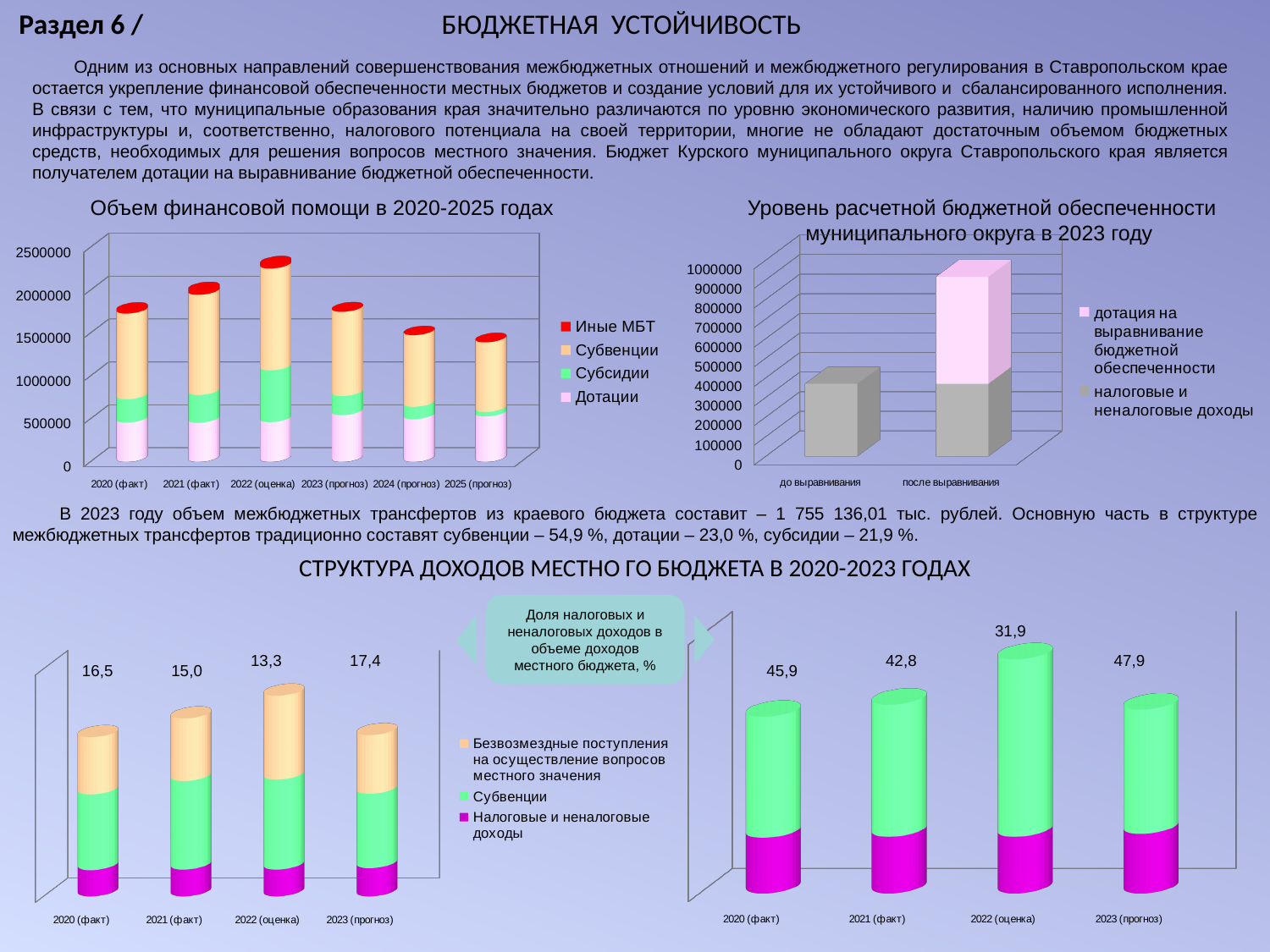
In the bottom-right chart, which year has the highest labelled value? 2023 (прогноз) In the bottom-left chart (share of tax and non-tax revenues), what is the value labelled for 2023 (прогноз)? 17,4 In the chart 'Уровень расчетной бюджетной обеспеченности муниципального округа в 2023 году', which category has the taller bar? после выравнивания In the chart 'Объем финансовой помощи в 2020-2025 годах', how many series does the legend list? 4 In the chart 'Объем финансовой помощи в 2020-2025 годах', is the total for 2020 (факт) greater or less than 2000000? less In the chart 'Уровень расчетной бюджетной обеспеченности муниципального округа в 2023 году', is the value for 'до выравнивания' greater or less than 500000? less In the chart 'Объем финансовой помощи в 2020-2025 годах', how many categories are shown on the x axis? 6 What kind of chart is the bottom-right chart? bar chart In the bottom-left chart (share of tax and non-tax revenues), what is the difference between the labelled values for 2023 (прогноз) and 2022 (оценка)? 4,1 In the bottom-left chart (share of tax and non-tax revenues), which year has the lowest labelled value? 2022 (оценка) In the chart 'Объем финансовой помощи в 2020-2025 годах', which category has the highest total bar? 2022 (оценка) In the bottom-right chart, what is the value labelled for 2021 (факт)? 42,8